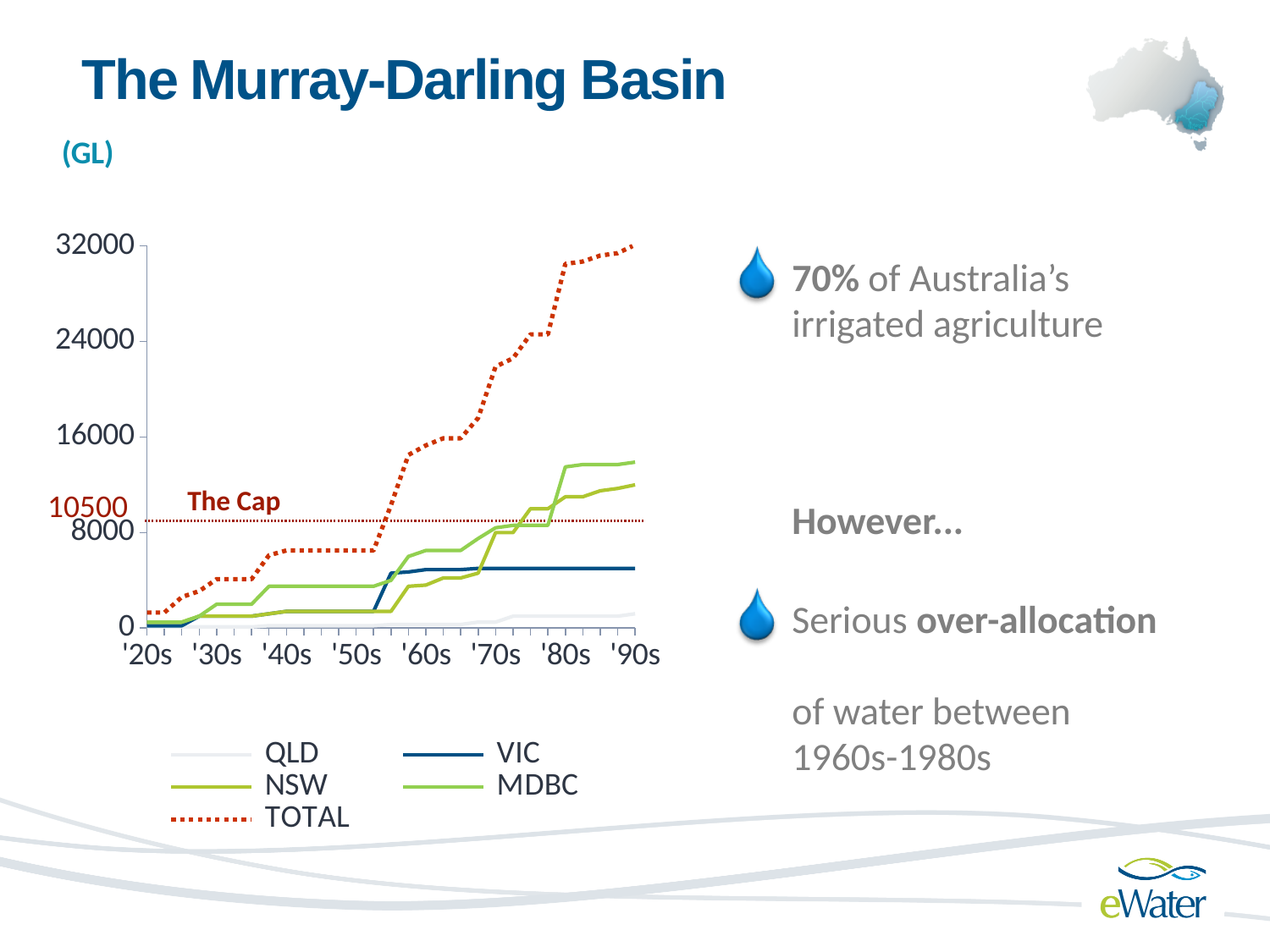
Is the VIC value in the '90s greater or less than 8000? less In the '90s, which is larger, the MDBC value or the VIC value? MDBC Which series is drawn with a dotted line? TOTAL How many series does the chart legend list? 5 How many decades are labelled along the x axis of the chart? 8 Which series has the lowest value in the '90s? QLD Does the TOTAL series rise or fall from the '20s to the '90s? rises What kind of chart is shown on the slide? line chart Is the TOTAL value in the '90s greater or less than 24000? greater What value is labelled as 'The Cap' on the chart? 10500 Is the TOTAL value in the '20s greater or less than 8000? less Which series has the highest value in the '90s? TOTAL